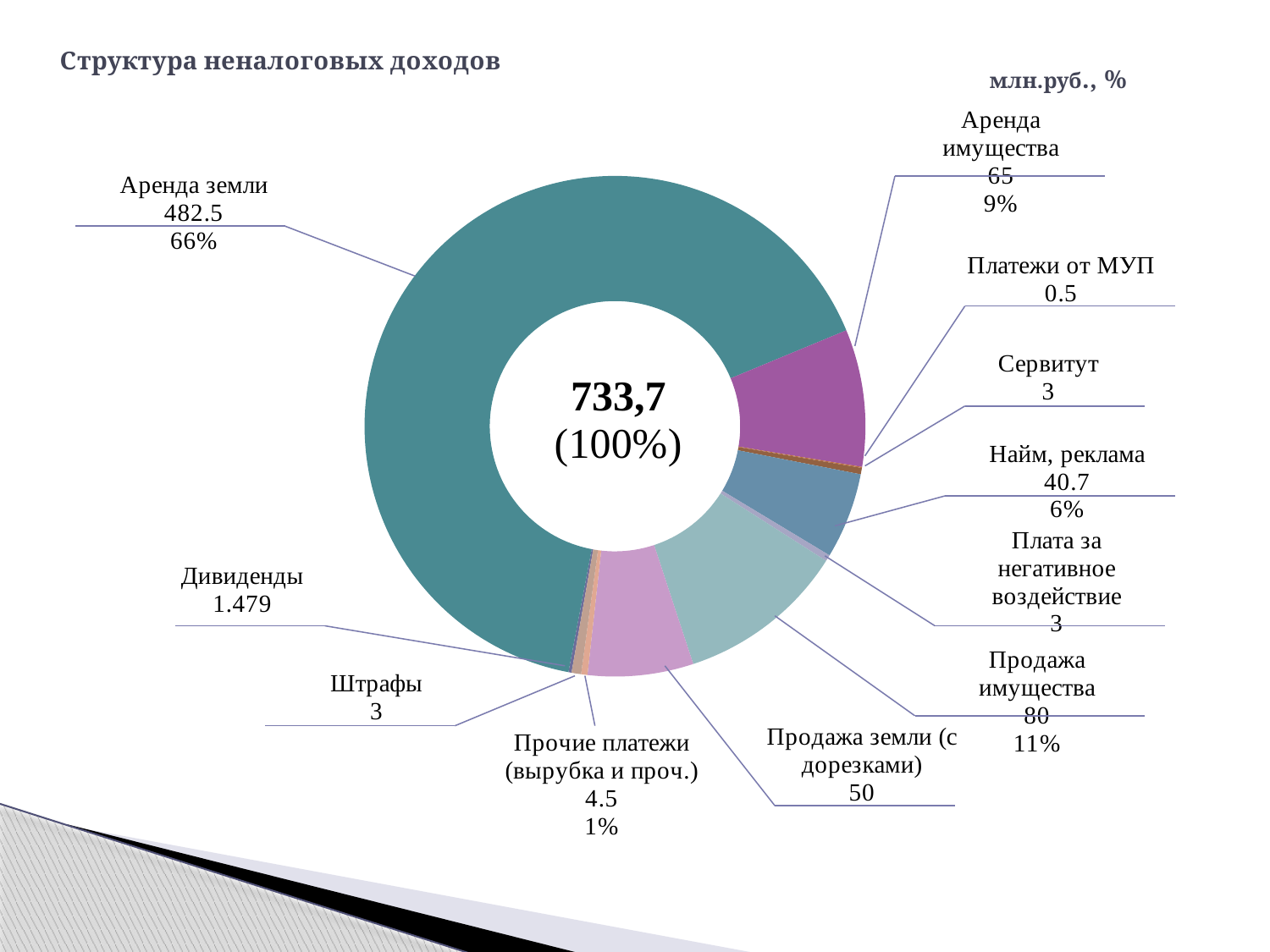
What is the value for Платежи от МУП? 0.5 How many categories are shown in the chart? 11 Which is larger, Аренда имущества or Найм, реклама? Аренда имущества What is the difference between Продажа имущества and Продажа земли (с дорезками)? 30 What is the value for Продажа имущества? 80 What share of the total does Аренда земли represent? 66% Which category has the highest value? Аренда земли What total value is shown in the centre of the chart? 733,7 What is the value for Дивиденды? 1.479 Which category has the lowest value? Платежи от МУП What is the value for Аренда земли? 482.5 What is the value for Найм, реклама? 40.7